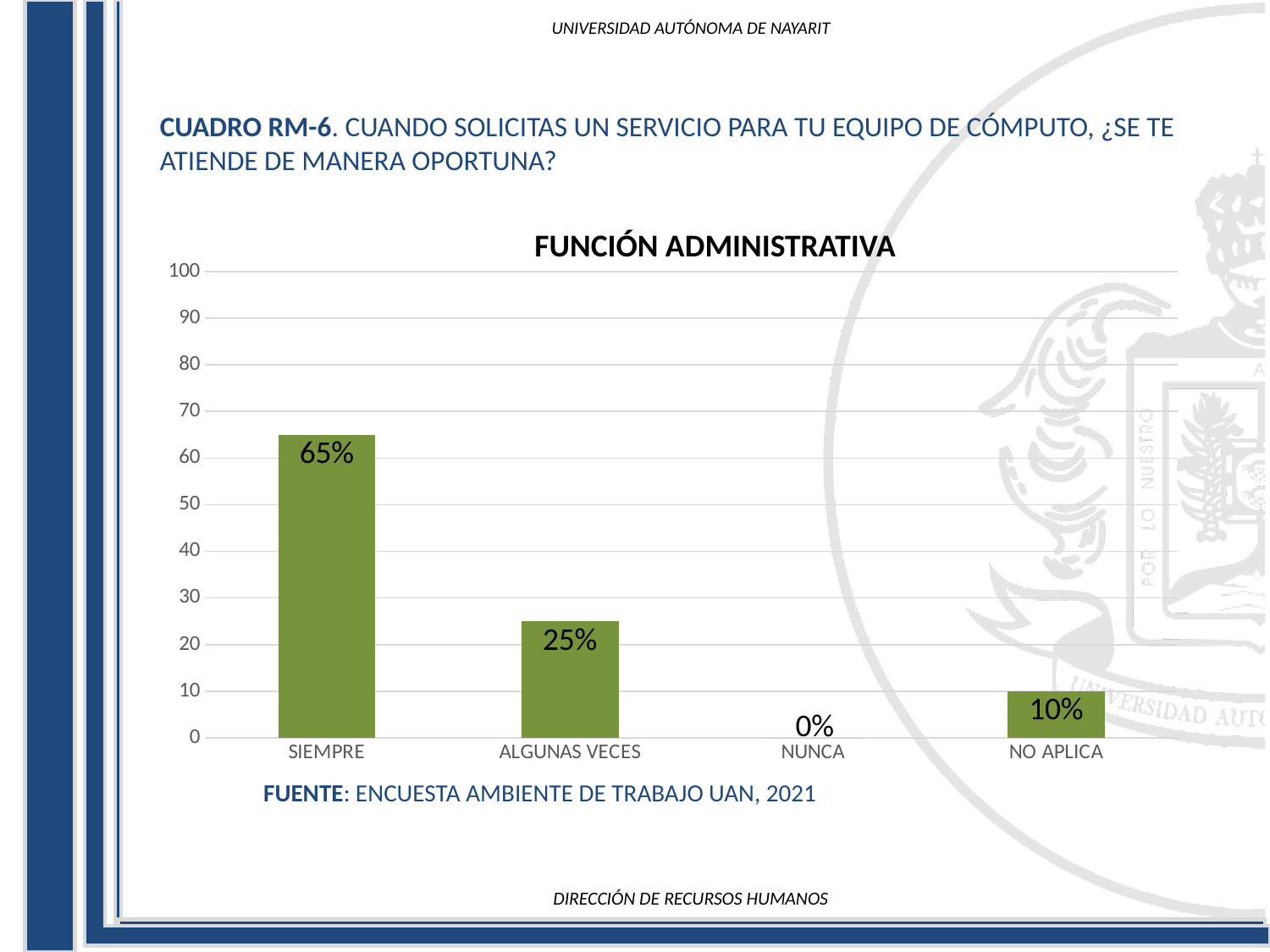
Which category has the lowest value? NUNCA What is the value for ALGUNAS VECES? 25% What kind of chart is shown on the slide? bar chart How many categories are shown on the x axis? 4 What is the value for SIEMPRE? 65% What is the value for NO APLICA? 10% What is the title of the chart? FUNCIÓN ADMINISTRATIVA Is the value for SIEMPRE greater or less than 60? greater Which is larger, the value for ALGUNAS VECES or the value for NO APLICA? ALGUNAS VECES What is the difference between the values for SIEMPRE and ALGUNAS VECES? 40% Which category has the highest value? SIEMPRE What is the value for NUNCA? 0%